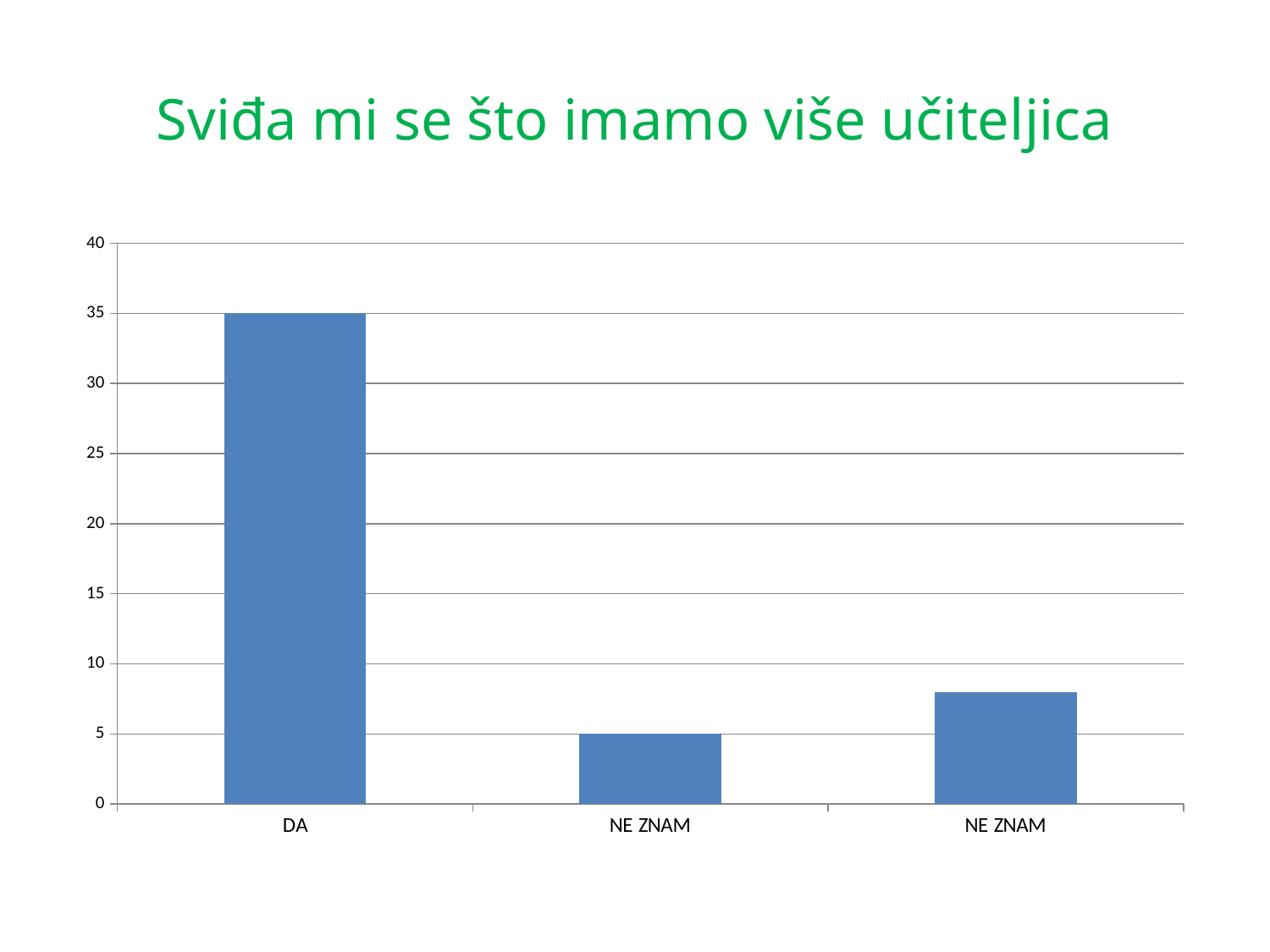
What is the value of the middle bar (the first NE ZNAM bar)? 5 Is the value of the DA bar greater or less than 30? greater Which is larger, the DA bar or the middle NE ZNAM bar? DA Which bar has the lowest value? The middle bar (NE ZNAM) What is the title of the slide? Sviđa mi se što imamo više učiteljica What kind of chart is shown on the slide? Bar chart How many bars are shown in the chart? 3 What is the difference between the DA bar and the middle NE ZNAM bar? 30 Is the value of the rightmost bar (the second NE ZNAM bar) greater or less than 10? less What is the value of the DA bar? 35 Is the value of the rightmost bar (the second NE ZNAM bar) greater or less than 5? greater Which category has the highest value? DA